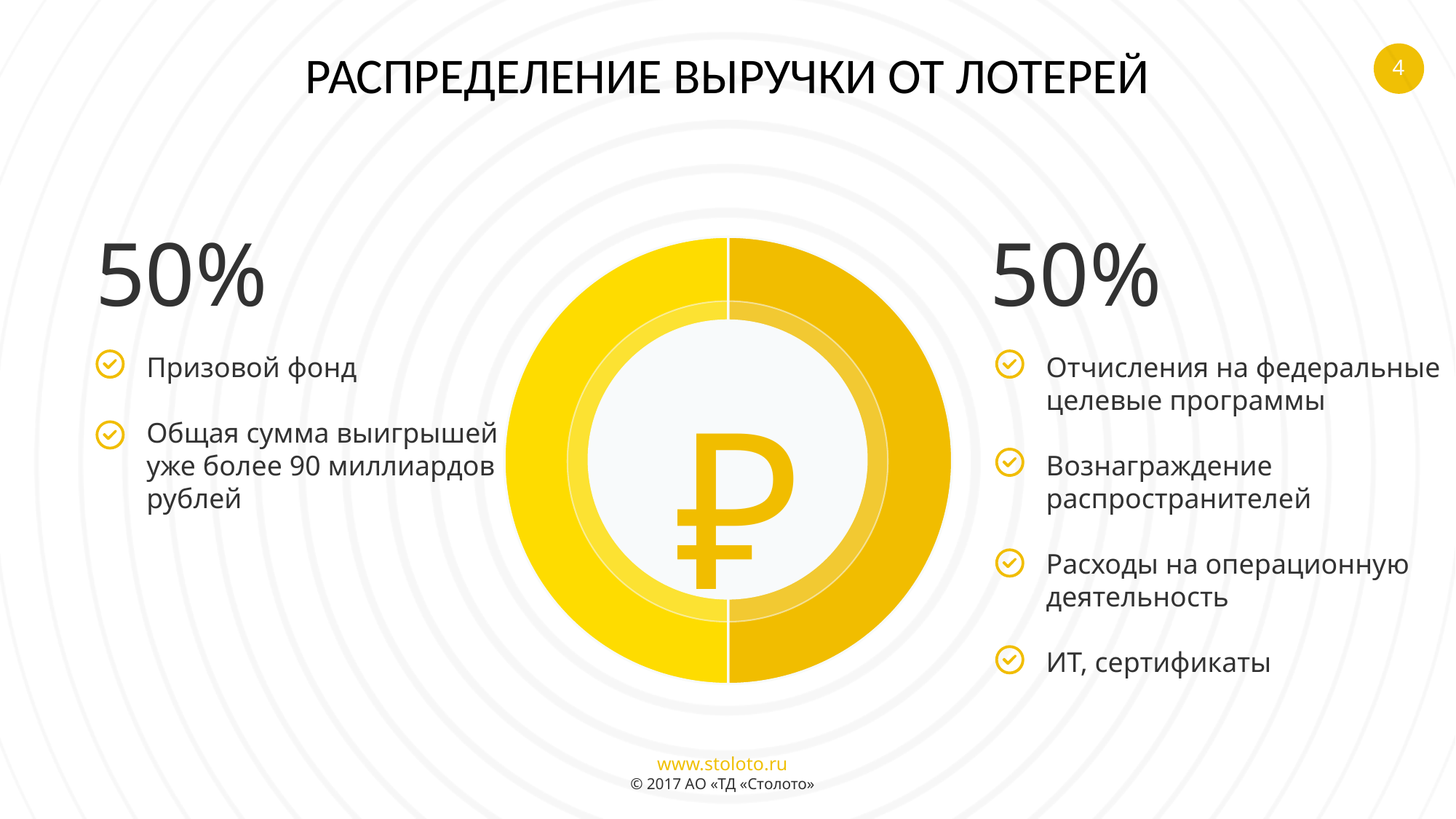
What do the two shares on the chart add up to? 100% Which slice is larger: the prize fund slice or the slice for federal programs and other expenses? They are equal What kind of chart is shown on the slide? pie chart (donut) What share of lottery revenue goes to the right-hand group (federal programs, distributor rewards, operating expenses, IT)? 50% What is the difference between the two shares shown on the chart? 0% What is the title of the slide containing the chart? РАСПРЕДЕЛЕНИЕ ВЫРУЧКИ ОТ ЛОТЕРЕЙ How many slices does the chart have? 2 Is the share for the prize fund greater or less than 40%? greater What symbol is shown in the centre of the donut chart? The ruble sign (₽) What share of lottery revenue goes to the prize fund (Призовой фонд)? 50%